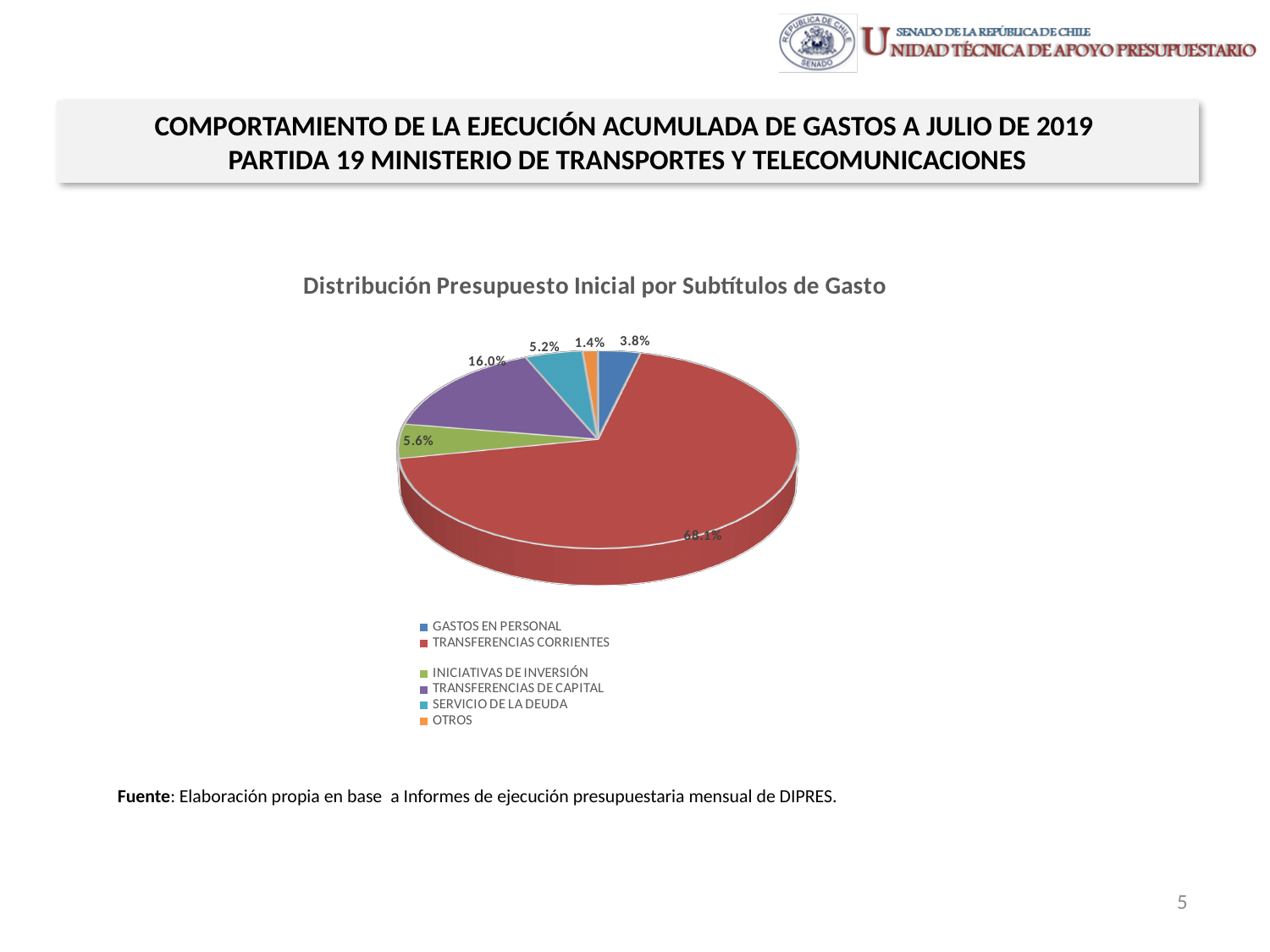
What share of the pie does GASTOS EN PERSONAL represent? 3.8% Which is larger, the share for INICIATIVAS DE INVERSIÓN or the share for GASTOS EN PERSONAL? INICIATIVAS DE INVERSIÓN What share of the pie does SERVICIO DE LA DEUDA represent? 5.2% What is the difference in percentage points between TRANSFERENCIAS CORRIENTES and TRANSFERENCIAS DE CAPITAL? 52.1 percentage points What share of the pie does OTROS represent? 1.4% How many categories does the legend list? 6 Which category has the smallest slice of the pie? OTROS What kind of chart is shown on the slide? Pie chart Which category has the largest slice of the pie? TRANSFERENCIAS CORRIENTES What is the title of the chart? Distribución Presupuesto Inicial por Subtítulos de Gasto What share of the pie does TRANSFERENCIAS CORRIENTES represent? 68.1% What share of the pie does TRANSFERENCIAS DE CAPITAL represent? 16.0%